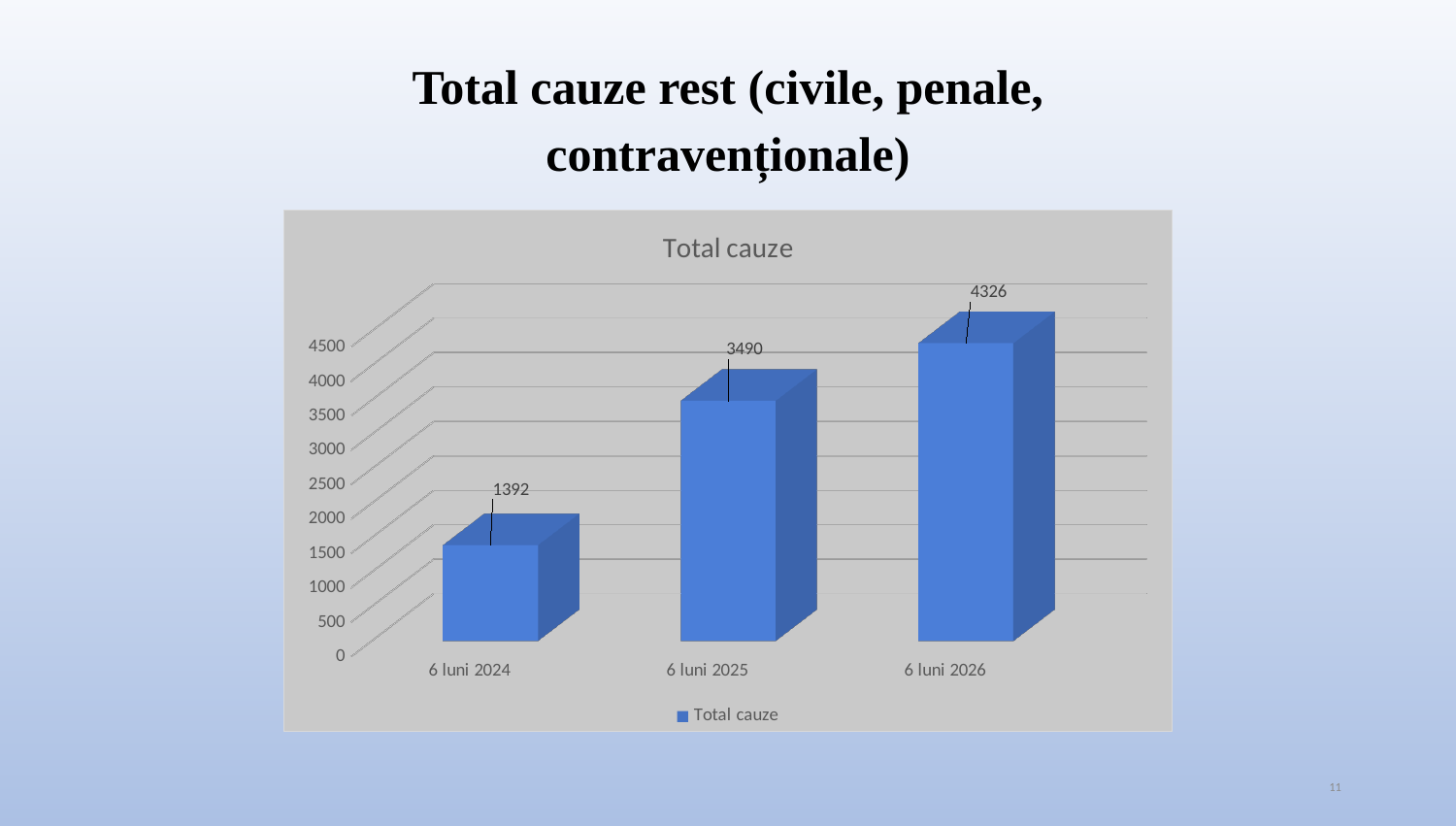
Which category has the highest value? 6 luni 2026 How many series does the legend list? 1 Which category has the lowest value? 6 luni 2024 What kind of chart is shown? bar chart What is the difference between the values for 6 luni 2025 and 6 luni 2024? 2098 Which is larger, the value for 6 luni 2024 or the value for 6 luni 2025? 6 luni 2025 What is the value for 6 luni 2025? 3490 Do the values rise or fall from 6 luni 2024 to 6 luni 2026? rise What is the difference between the values for 6 luni 2026 and 6 luni 2025? 836 What is the value for 6 luni 2024? 1392 What is the value for 6 luni 2026? 4326 How many categories are shown on the x axis? 3